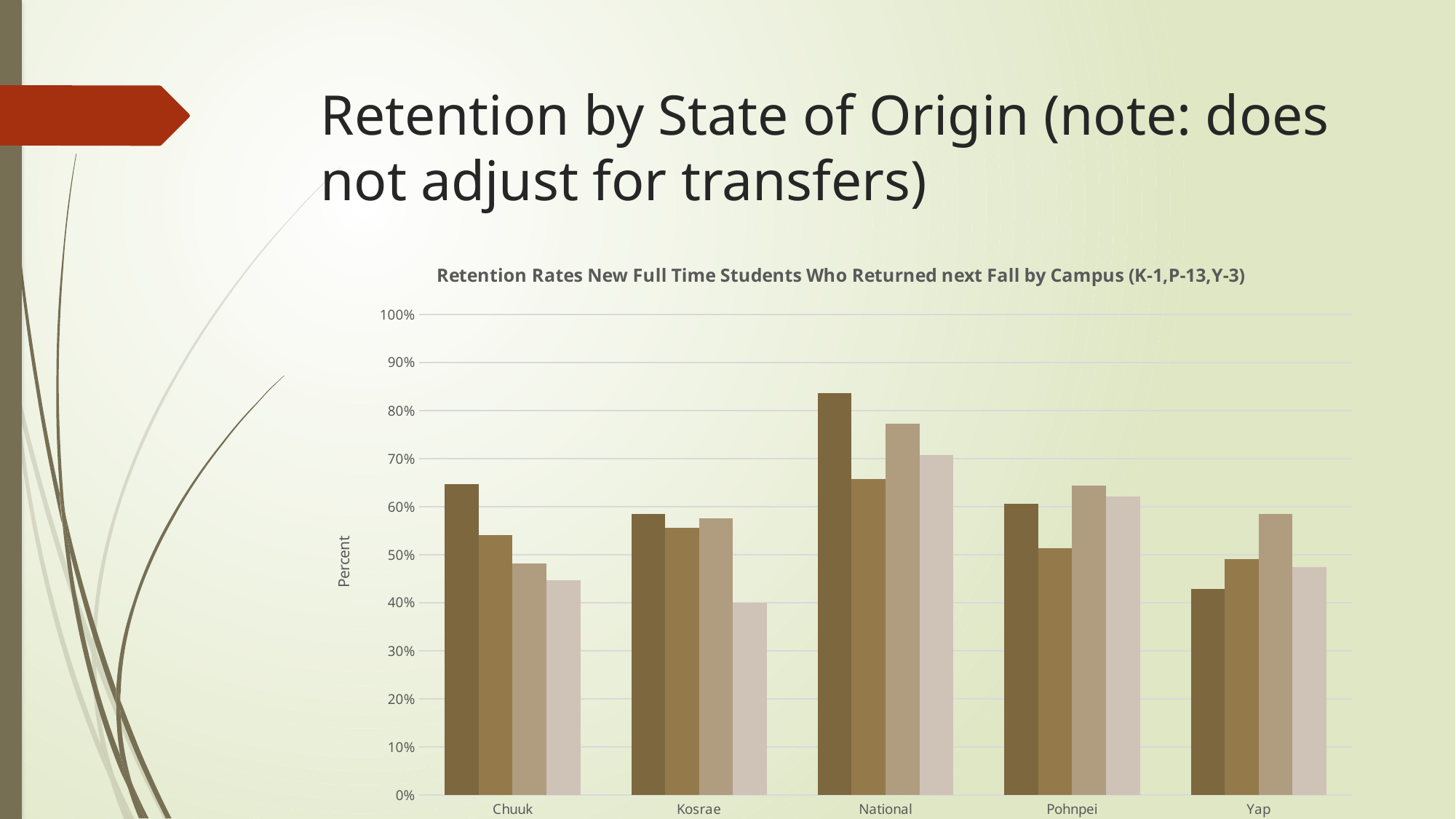
Is the value of the first (darkest) bar for Chuuk greater or less than 60%? greater What is the title of the chart? Retention Rates New Full Time Students Who Returned next Fall by Campus (K-1,P-13,Y-3) What kind of chart is shown on the slide? bar chart Is the value of the first (darkest) bar for National greater or less than 80%? greater Which campus has the lowest value for the first (darkest) bar in its group? Yap How many bars are plotted for each campus category in the chart? 4 Is the value of the first (darkest) bar for Yap greater or less than 50%? less How many campus categories are shown on the x axis of the chart? 5 Which campus has the tallest bar in the chart? National What is the label on the vertical axis of the chart? Percent Which is larger: the first (darkest) bar for Chuuk or the first (darkest) bar for Yap? Chuuk